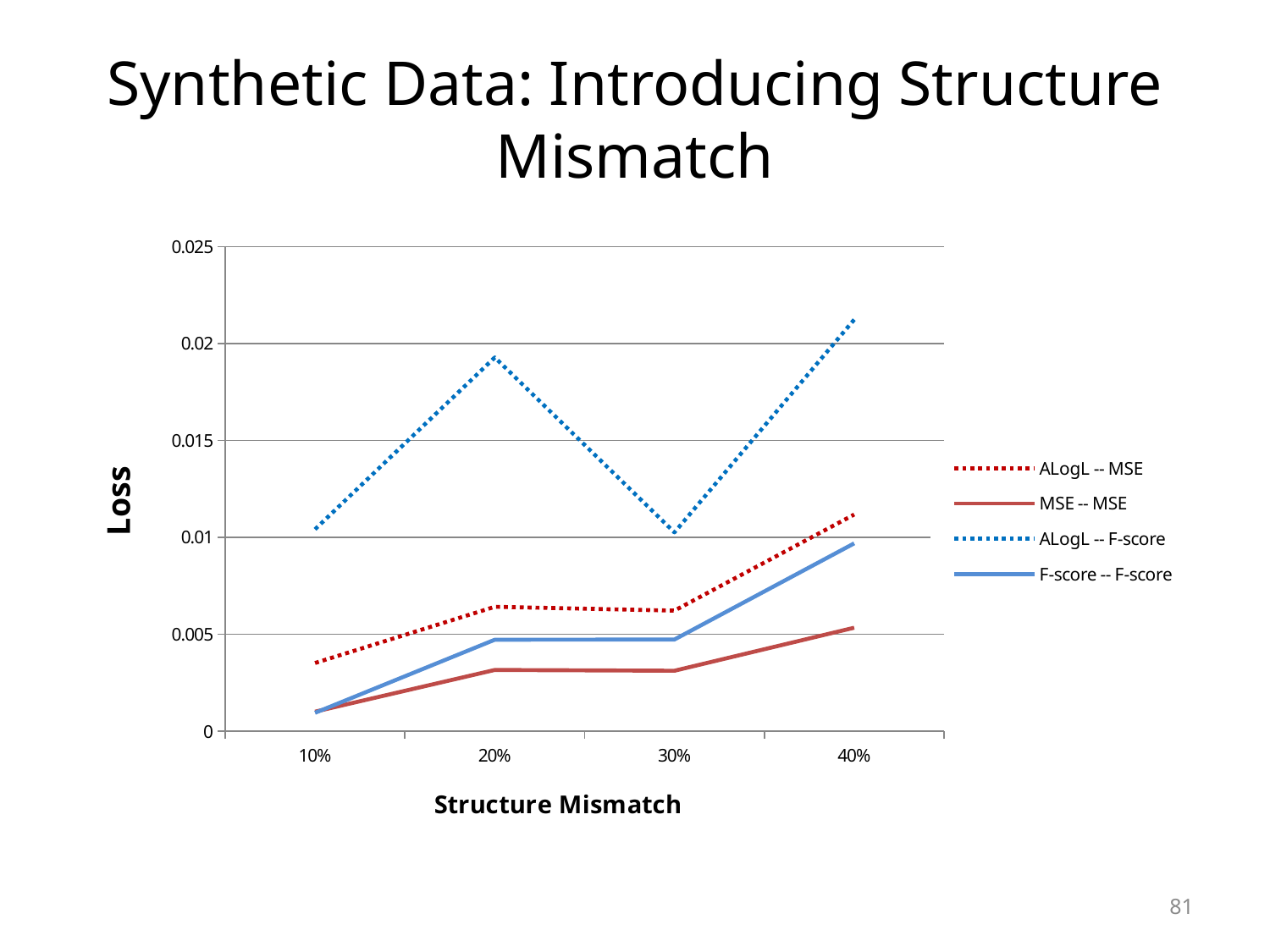
At 20% structure mismatch, which has the larger loss: ALogL -- MSE or F-score -- F-score? ALogL -- MSE What kind of chart is shown on the slide? line chart Is the loss for ALogL -- F-score at 40% greater or less than 0.02? greater What is the label of the vertical axis? Loss How many series does the legend list? 4 Is the loss for ALogL -- MSE at 10% greater or less than 0.005? less How many Structure Mismatch levels are plotted along the x axis? 4 Is the loss for MSE -- MSE at 40% greater or less than 0.01? less Which series has the lowest loss at 40% structure mismatch? MSE -- MSE Does the loss for MSE -- MSE rise or fall from 10% to 40% structure mismatch? rise Which series has the highest loss at 40% structure mismatch? ALogL -- F-score